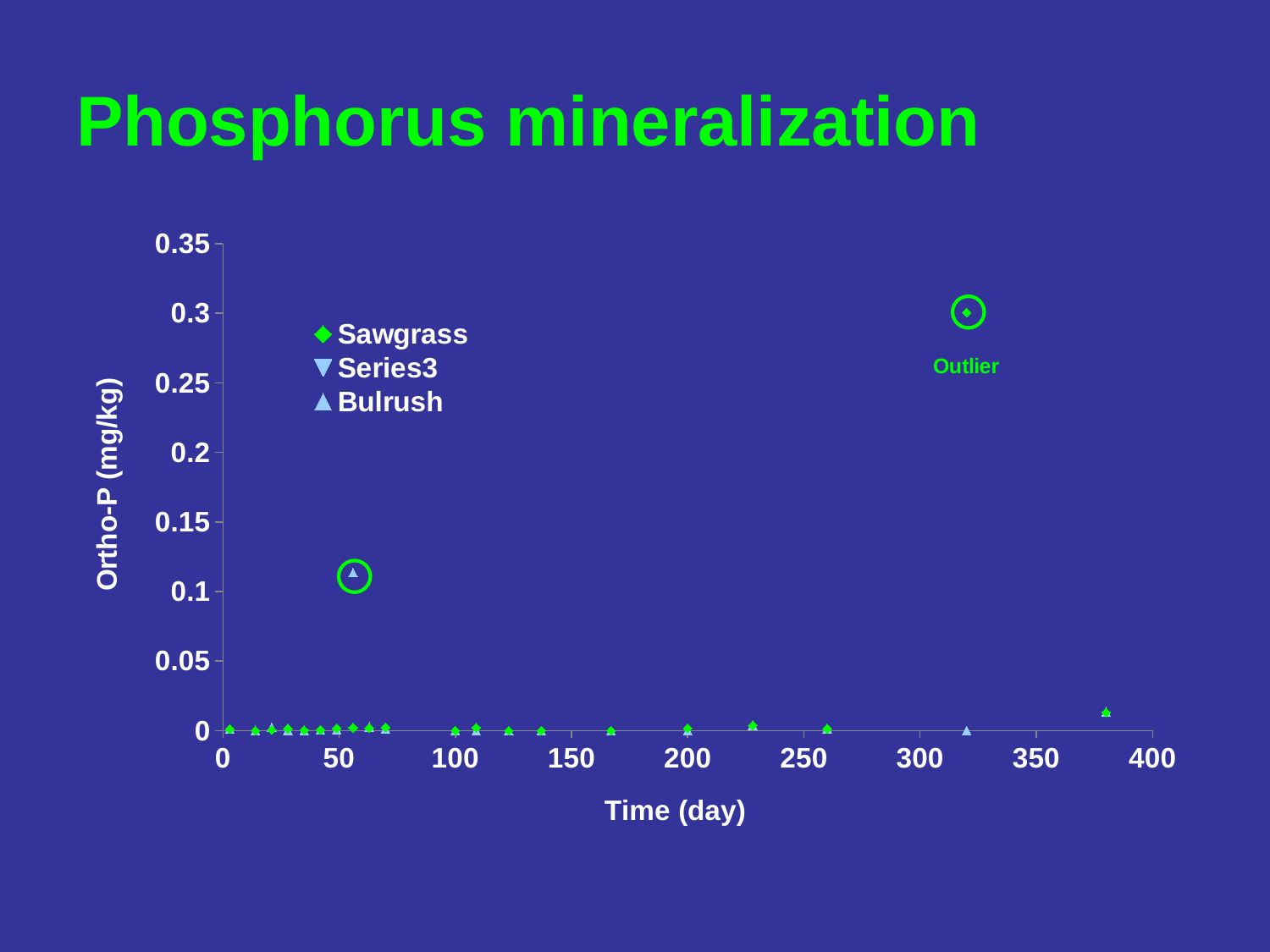
Is the value of the circled Bulrush point near day 55 greater or less than 0.15? less What kind of chart is shown on the slide? scatter chart What is the title of the y axis? Ortho-P (mg/kg) Is the Sawgrass value at day 380 greater or less than 0.05? less Which is higher: the circled Sawgrass point near day 320 or the circled Bulrush point near day 55? the Sawgrass point near day 320 Which series contains the highest plotted value on the chart? Sawgrass Is the Sawgrass value at day 228 greater or less than 0.05? less What are the three series named in the legend? Sawgrass, Series3, Bulrush How many series does the legend list? 3